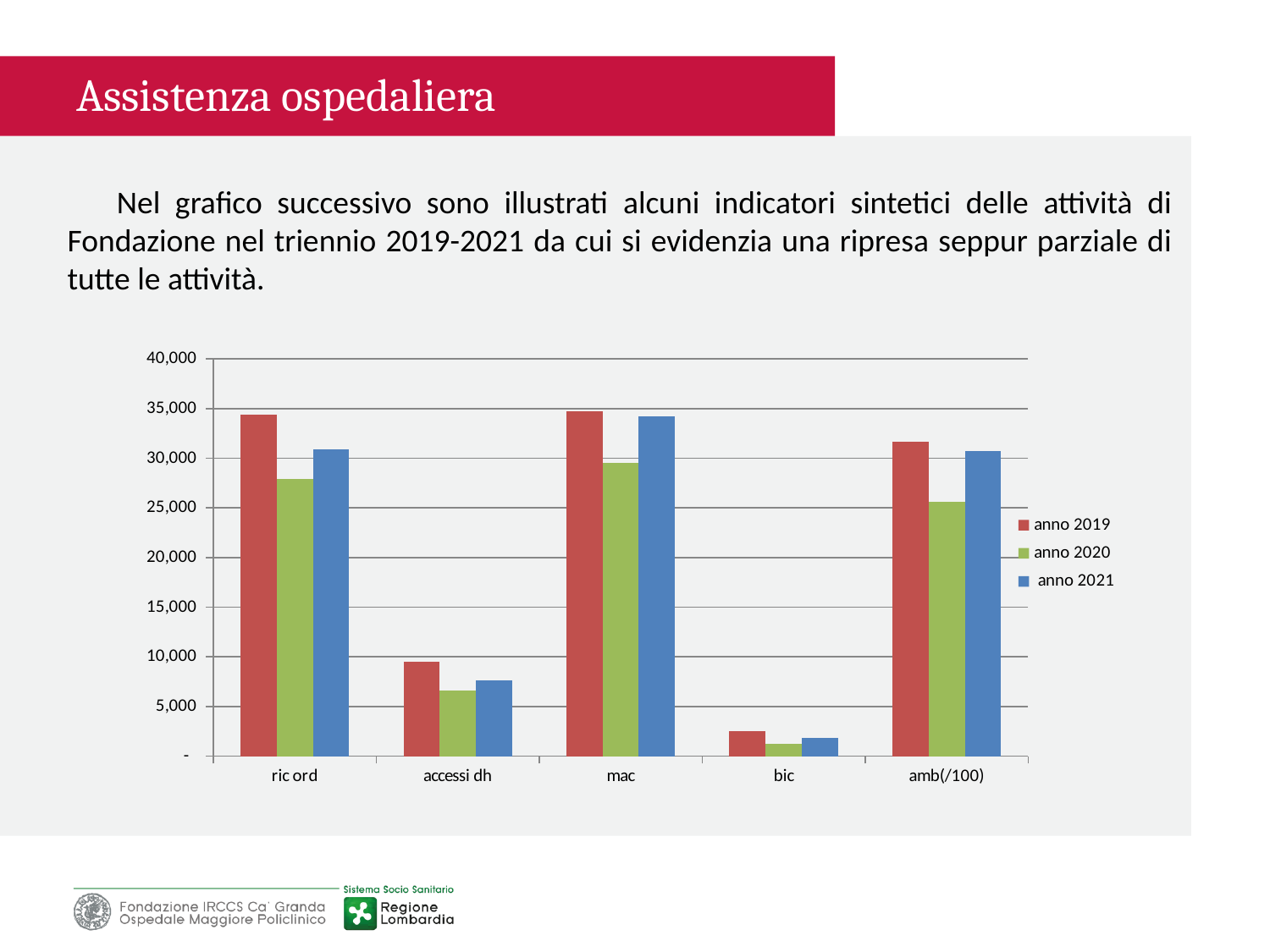
Which category has the lowest value for anno 2019? bic For amb(/100), which is larger: the anno 2020 value or the anno 2021 value? anno 2021 Which category has the highest value for anno 2020? mac Is the anno 2019 value for bic greater or less than 5,000? less How many categories are shown on the x axis of the chart? 5 Which legend entry is shown in blue? anno 2021 Is the anno 2021 value for mac greater or less than 30,000? greater How many series does the chart's legend list? 3 For ric ord, which is larger: the anno 2019 value or the anno 2020 value? anno 2019 Is the anno 2019 value for ric ord greater or less than 30,000? greater What kind of chart is shown on the slide? bar chart